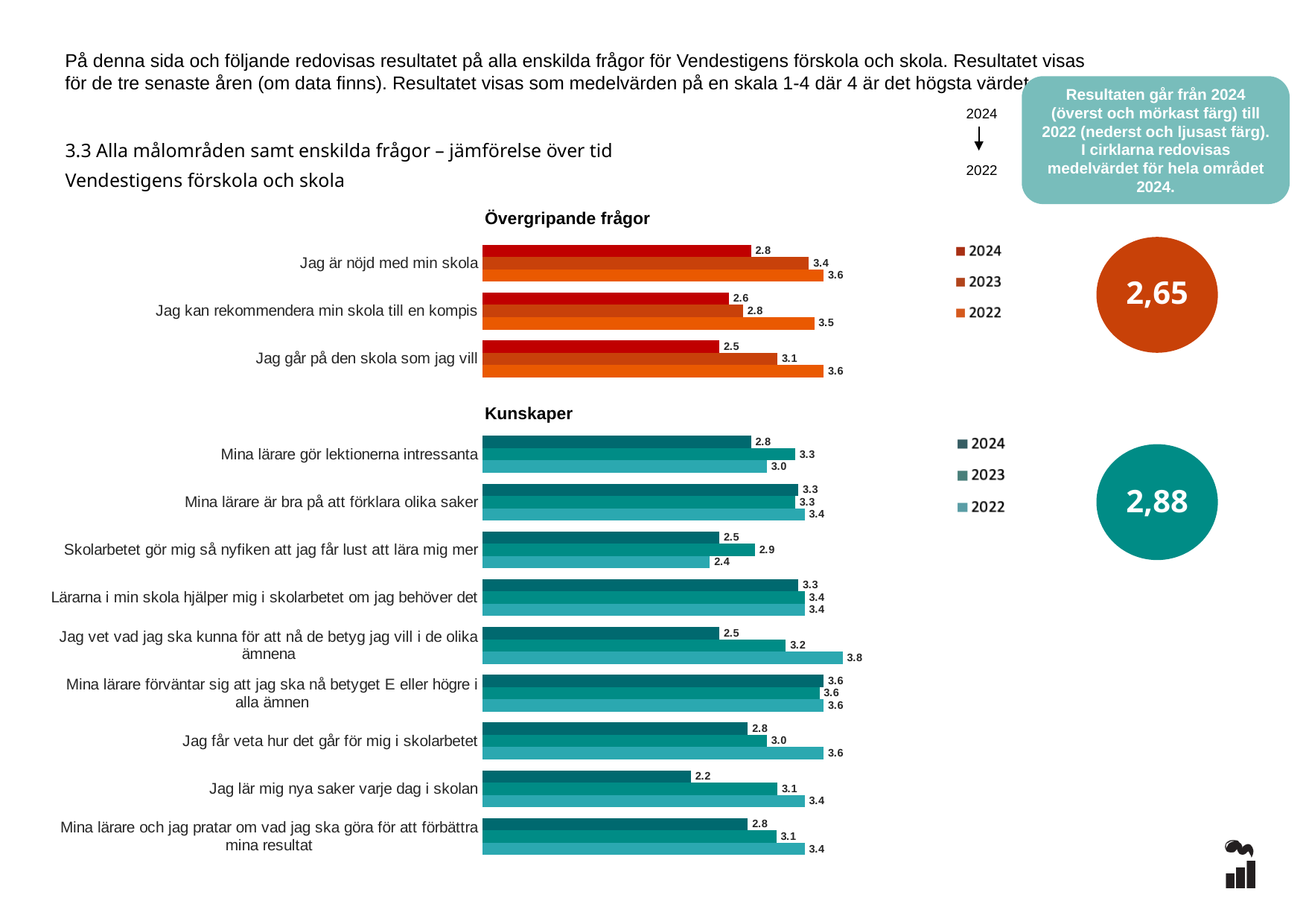
In the 'Kunskaper' chart, which question has the highest 2024 value? Mina lärare förväntar sig att jag ska nå betyget E eller högre i alla ämnen What value is shown in the circle next to the 'Kunskaper' chart? 2,88 What type of chart is used for 'Kunskaper'? bar chart In the 'Kunskaper' chart, is the 2024 value for 'Mina lärare gör lektionerna intressanta' larger or smaller than the 2023 value? smaller In the 'Övergripande frågor' chart, which question has the lowest 2024 value? Jag går på den skola som jag vill In the 'Övergripande frågor' chart, what is the 2024 value for 'Jag är nöjd med min skola'? 2.8 In the 'Kunskaper' chart, what is the 2024 value for 'Jag lär mig nya saker varje dag i skolan'? 2.2 In the 'Kunskaper' chart, how many questions (categories) are shown? 9 In the 'Övergripande frågor' chart, what is the 2022 value for 'Jag kan rekommendera min skola till en kompis'? 3.5 In the 'Övergripande frågor' chart, how many series does the legend list? 3 In the 'Kunskaper' chart, what is the 2022 value for 'Jag vet vad jag ska kunna för att nå de betyg jag vill i de olika ämnena'? 3.8 In the 'Övergripande frågor' chart, what is the difference between the 2022 and 2024 values for 'Jag går på den skola som jag vill'? 1.1